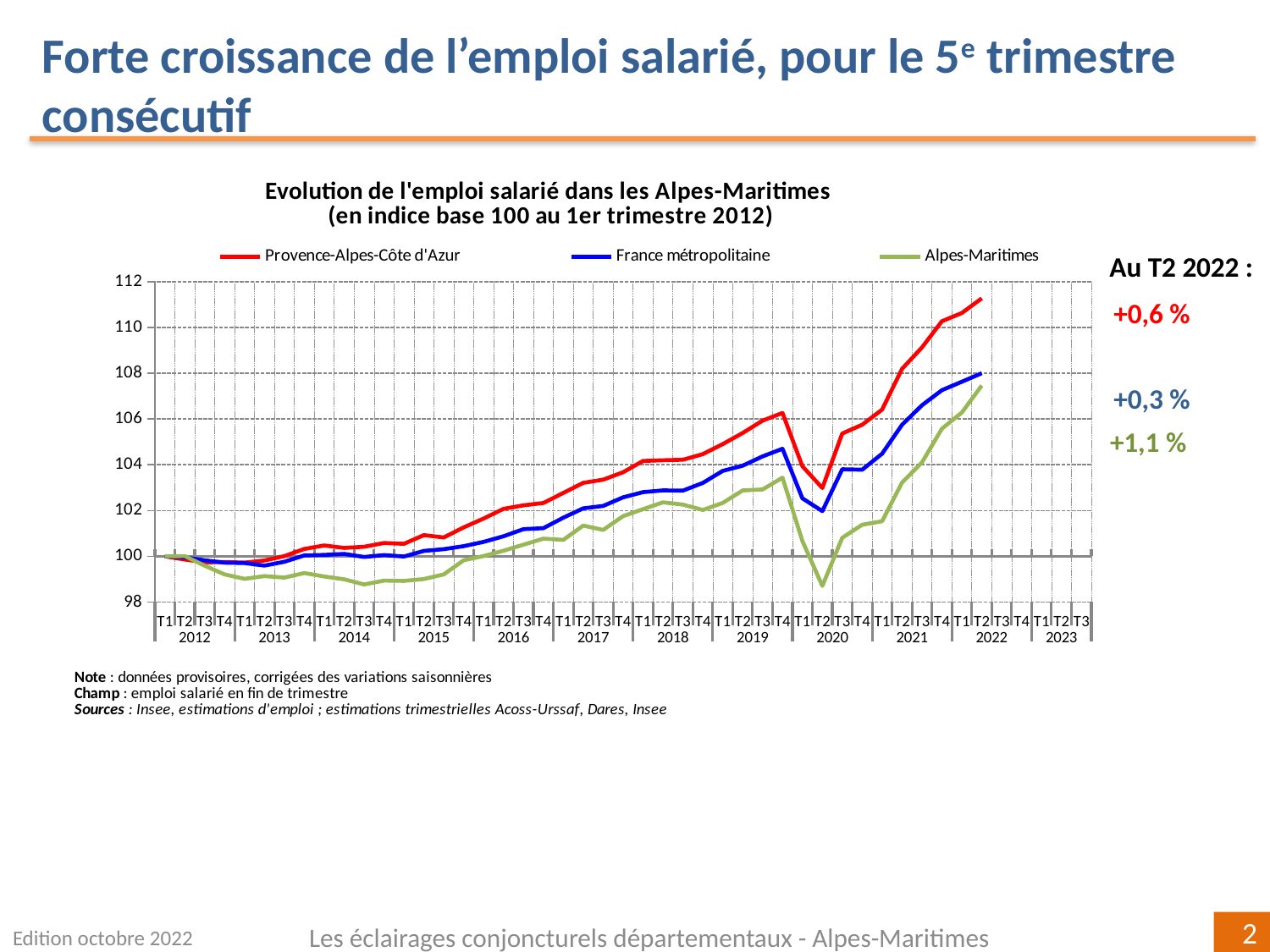
What is the base period of the index according to the chart title? 1er trimestre 2012 Is the value for Alpes-Maritimes at T2 2020 greater or less than 100? less What type of chart is shown on the slide? line chart Which series has the lowest value at T2 2020? Alpes-Maritimes Is the value for France métropolitaine at T2 2022 greater or less than 106? greater How many series does the legend list? 3 Which series is drawn in green in the legend? Alpes-Maritimes Does the Provence-Alpes-Côte d'Azur series rise or fall overall between T1 2012 and T2 2022? rise What quarterly change is annotated for Alpes-Maritimes at T2 2022? +1,1 % At T2 2022, which series has the higher value: Provence-Alpes-Côte d'Azur or France métropolitaine? Provence-Alpes-Côte d'Azur Is the value for Alpes-Maritimes at T4 2014 greater or less than 100? less